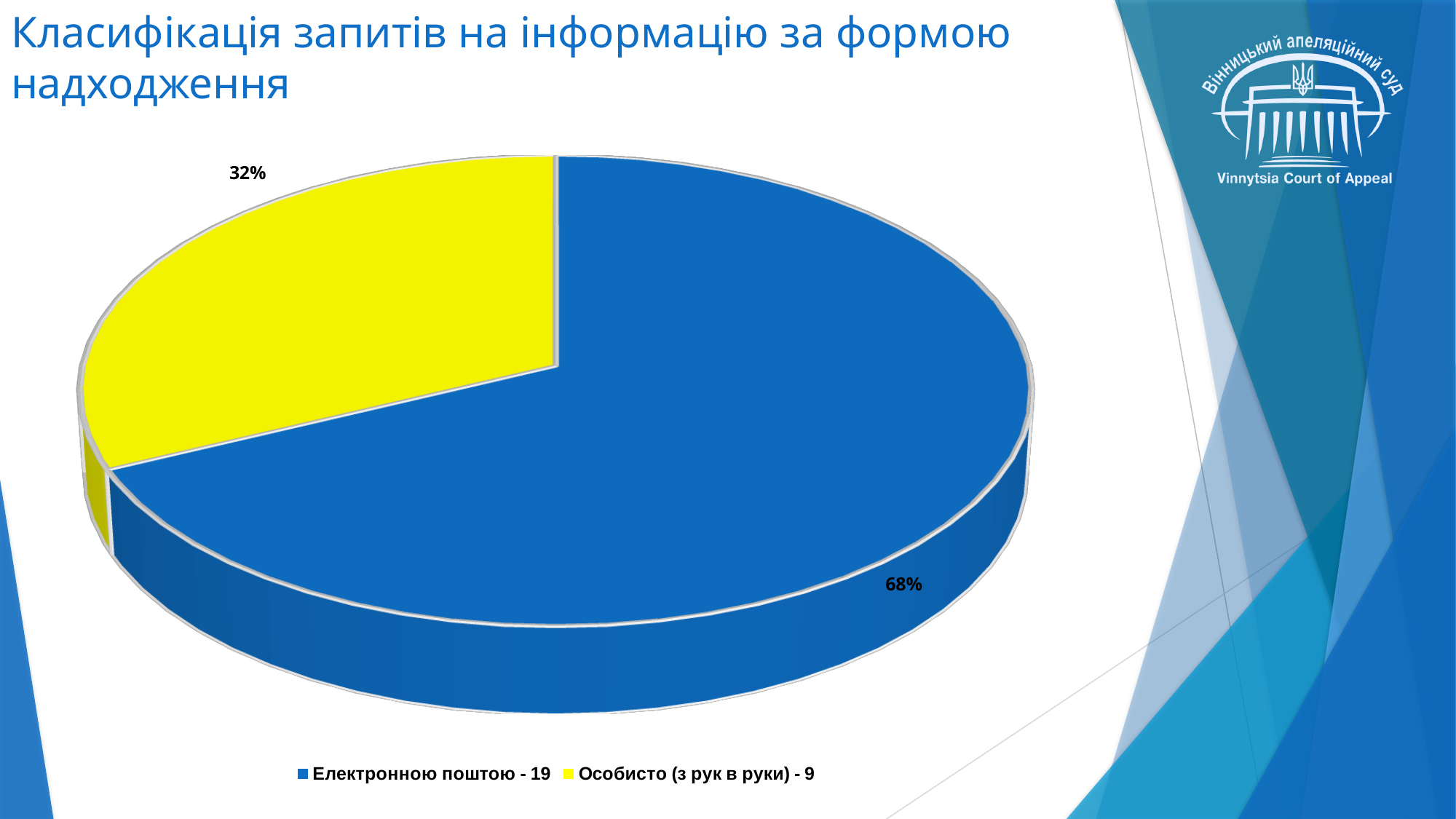
Which category has the smallest share of the pie? Особисто (з рук в руки) Which is larger: the share for "Електронною поштою" or for "Особисто (з рук в руки)"? Електронною поштою What colour is the "Особисто (з рук в руки)" slice? Yellow What is the difference in percentage points between the "Електронною поштою" and "Особисто (з рук в руки)" slices? 36 percentage points What share of the pie does the "Електронною поштою" slice represent? 68% What kind of chart is shown on the slide? Pie chart How many requests were received "Електронною поштою" according to the legend? 19 Which category has the largest share of the pie? Електронною поштою How many slices does the pie chart have? 2 How many requests were received "Особисто (з рук в руки)" according to the legend? 9 What is the difference between the number of requests received by e-mail (Електронною поштою) and in person (Особисто)? 10 What share of the pie does the "Особисто (з рук в руки)" slice represent? 32%